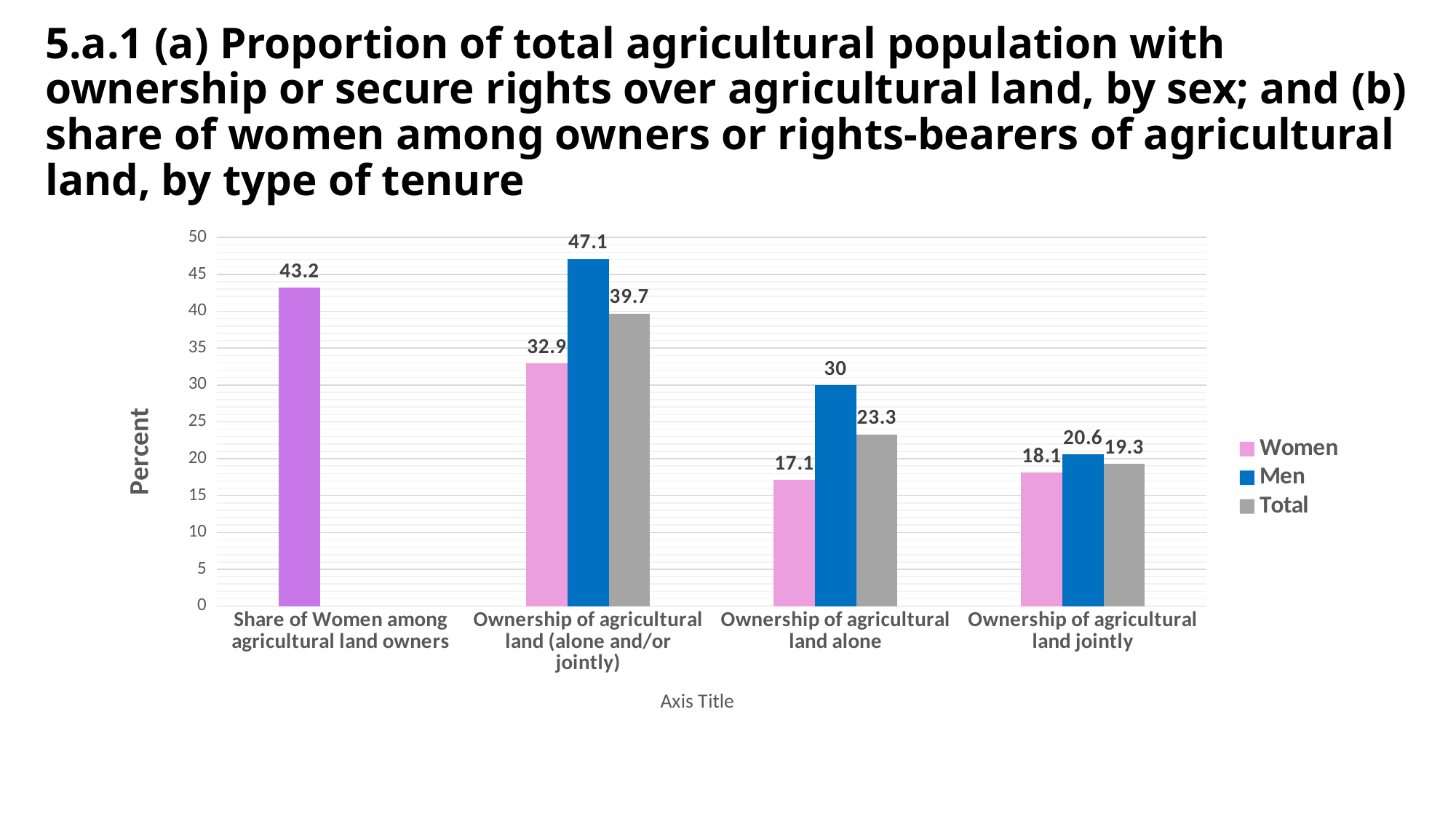
Is the Total value for Ownership of agricultural land (alone and/or jointly) greater or less than 35? greater What is the value for Women for Ownership of agricultural land (alone and/or jointly)? 32.9 What is the value for Total for Ownership of agricultural land jointly? 19.3 How many categories are shown on the x axis? 4 What is the value shown for Share of Women among agricultural land owners? 43.2 What kind of chart is shown on the slide? Bar chart Which category has the highest value for Men? Ownership of agricultural land (alone and/or jointly) What is the value for Men for Ownership of agricultural land alone? 30 How many series does the legend list? 3 Which is larger for Ownership of agricultural land jointly: the Men value or the Total value? Men Which category has the lowest value for Women? Ownership of agricultural land alone What is the difference between the Men and Women values for Ownership of agricultural land alone? 12.9